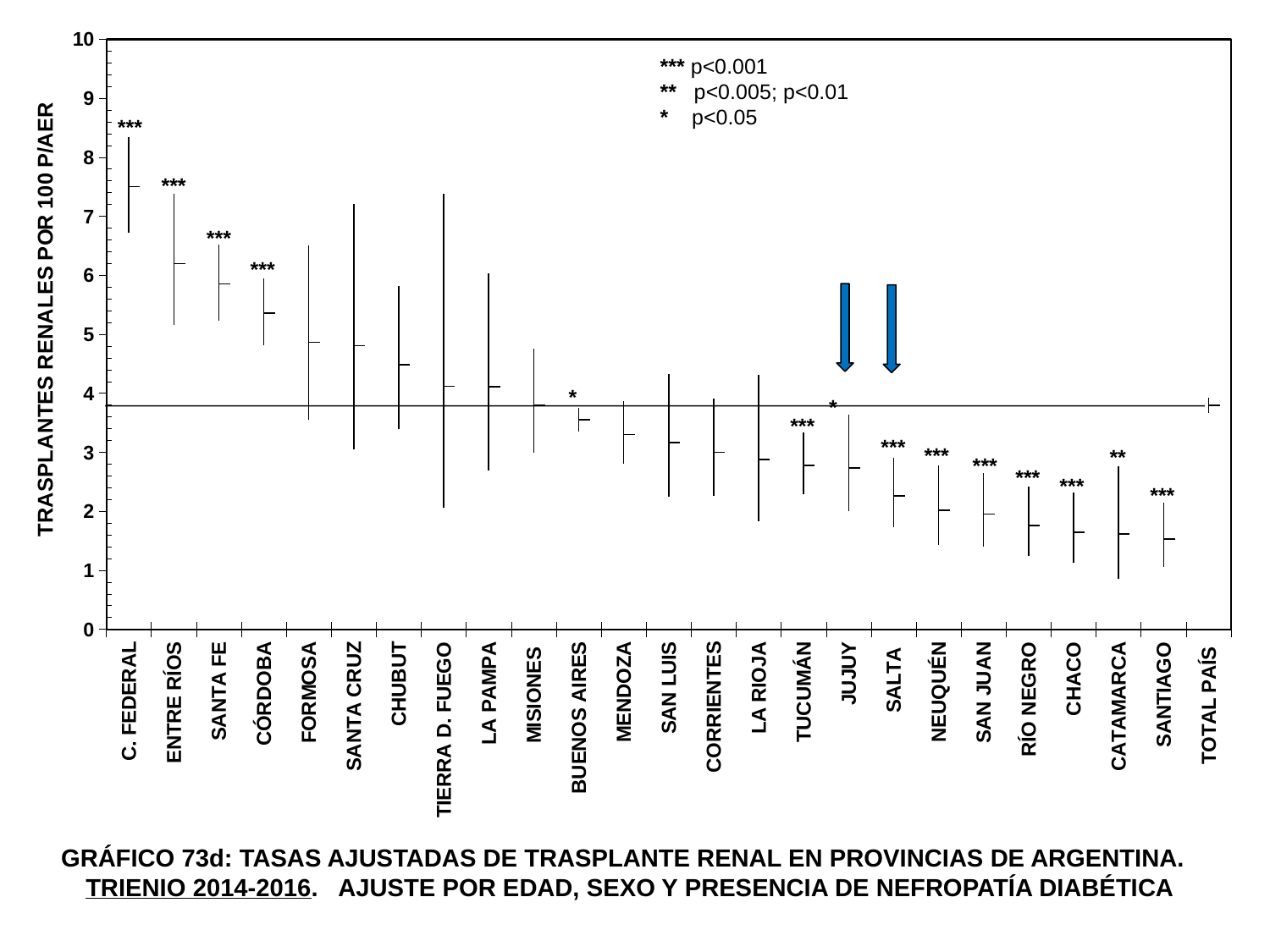
Which category has the highest adjusted transplant rate? C. FEDERAL Is the value for SALTA greater or less than 3? less What is the label of the y axis? TRASPLANTES RENALES POR 100 P/AER How many categories are shown along the x axis? 25 Is the value for ENTRE RÍOS greater or less than 6? greater According to the legend, what p-value does '***' indicate? p<0.001 Is the value for C. FEDERAL greater or less than 7? greater Do the plotted values generally rise or fall from left to right along the x axis? fall What kind of chart is shown on the slide? High-low (error bar) chart Which is larger, the value for SANTA FE or the value for SALTA? SANTA FE